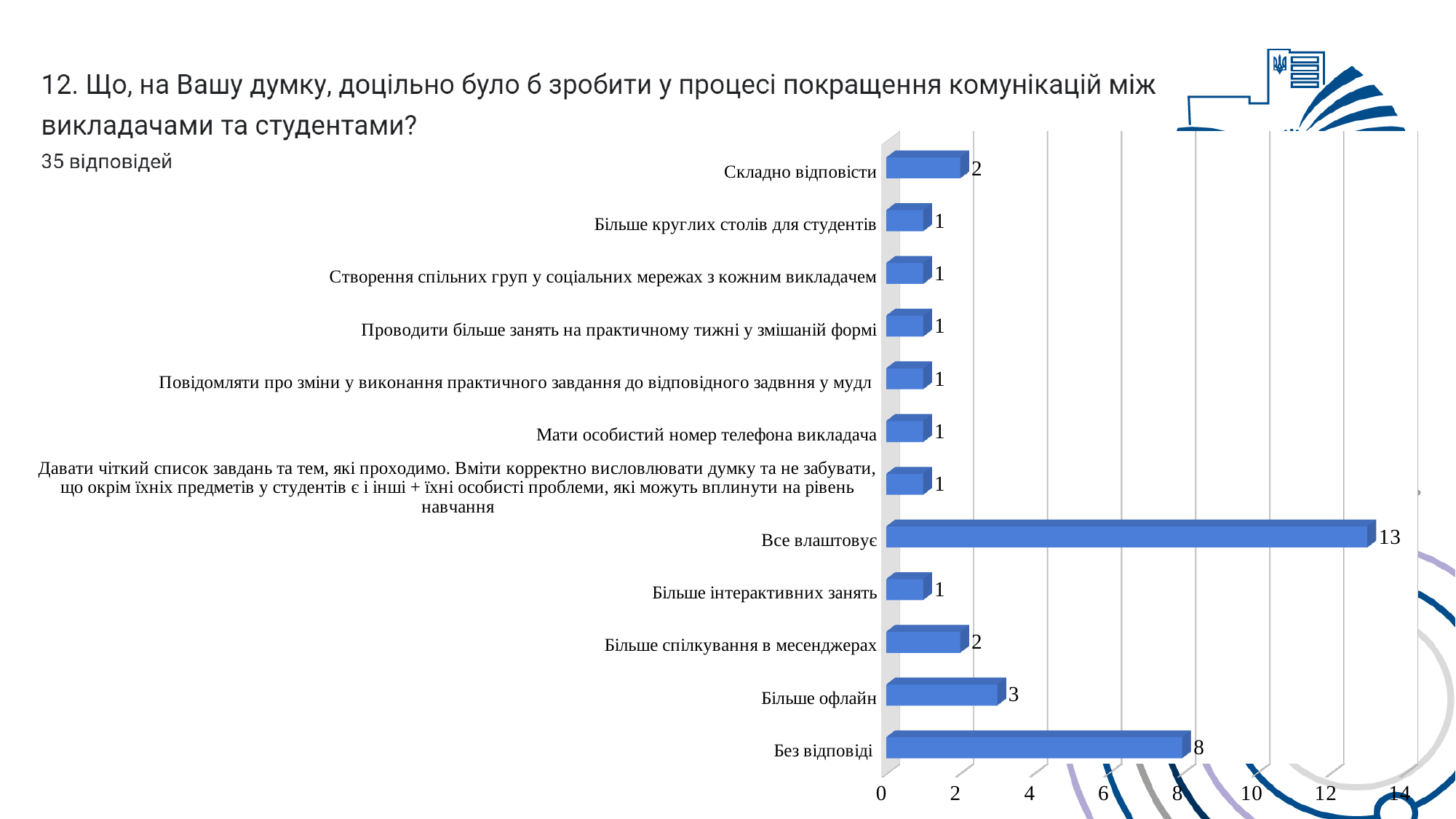
What is the value for "Без відповіді"? 8 How many responses does the slide say the chart is based on? 35 відповідей What is the value for "Більше офлайн"? 3 What is the difference between the values for "Більше офлайн" and "Складно відповісти"? 1 What is the value for "Все влаштовує"? 13 How many categories are shown in the chart? 12 What is the value for "Більше спілкування в месенджерах"? 2 Which category has the highest value? Все влаштовує What type of chart is shown on the slide? bar chart Which is larger, the value for "Без відповіді" or the value for "Більше офлайн"? Без відповіді What is the value for "Мати особистий номер телефона викладача"? 1 What is the difference between the values for "Все влаштовує" and "Без відповіді"? 5